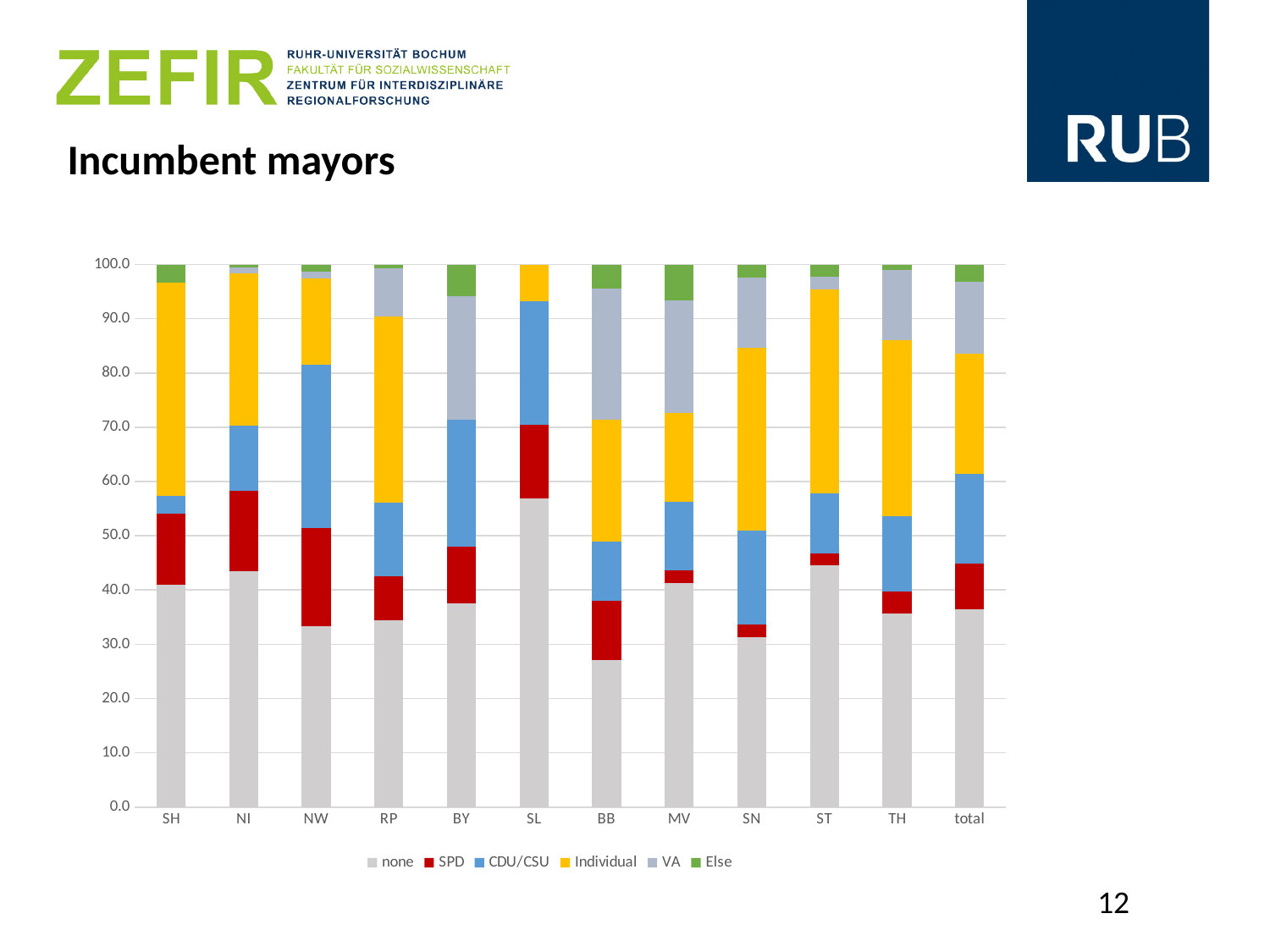
Which has the larger SPD segment, NW or MV? NW Is the 'none' value for BB greater or less than 30? less What is the title of the chart on the slide? Incumbent mayors Is the 'none' value for SL greater or less than 50? greater How many categories are shown along the x axis of the chart? 12 Which category has the smallest 'none' segment? BB Which series is shown in yellow in the chart? Individual Is the 'none' value for total greater or less than 40? less Which category has the largest 'none' segment? SL How many series does the legend of the chart list? 6 Which has the larger 'none' segment, NW or ST? ST What kind of chart is shown on the slide? stacked bar chart